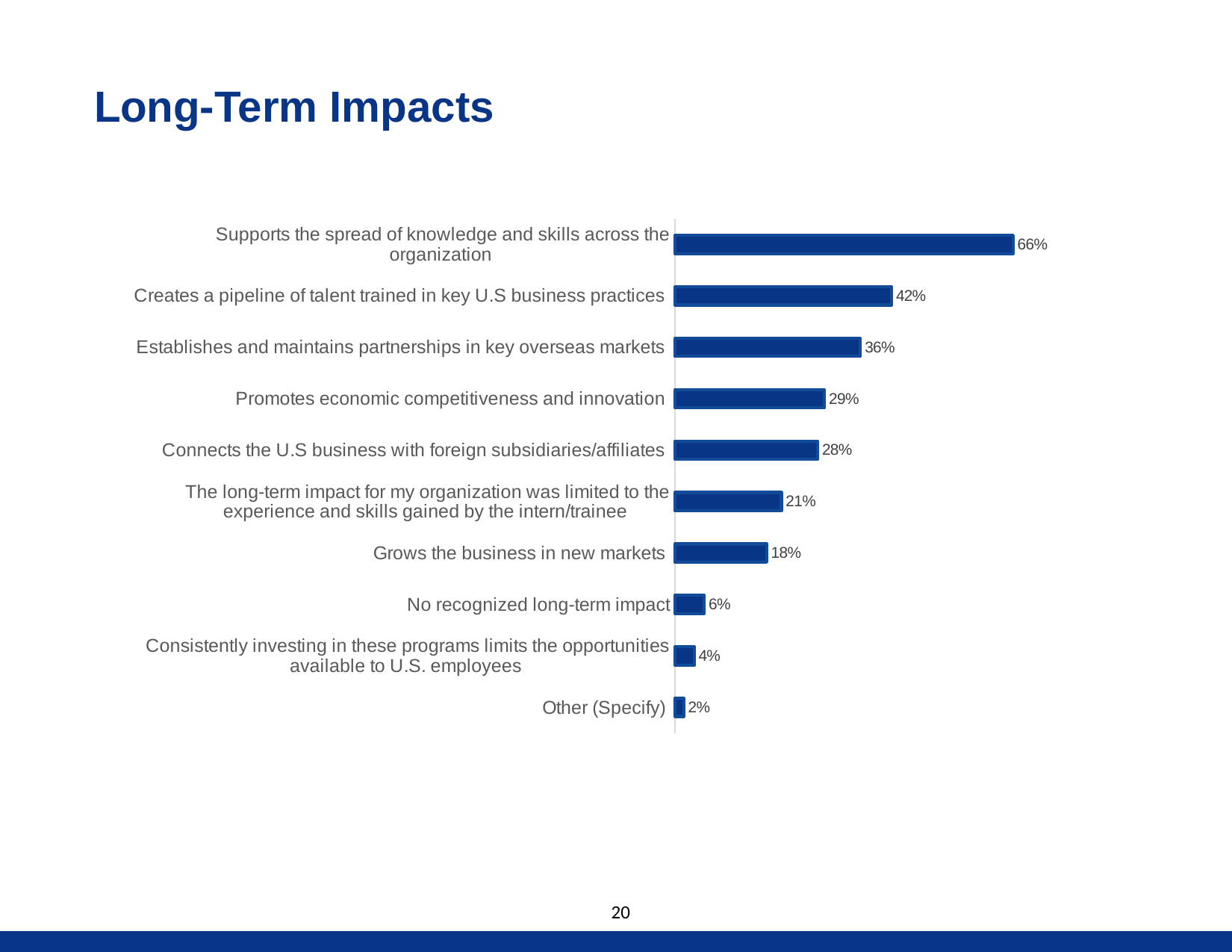
What is the difference between 'Establishes and maintains partnerships in key overseas markets' and 'Grows the business in new markets'? 18% What is the value for 'The long-term impact for my organization was limited to the experience and skills gained by the intern/trainee'? 21% Which category has the highest value? Supports the spread of knowledge and skills across the organization Which is larger: 'Promotes economic competitiveness and innovation' or 'Grows the business in new markets'? Promotes economic competitiveness and innovation What percentage is shown for 'No recognized long-term impact'? 6% What percentage is shown for 'Creates a pipeline of talent trained in key U.S business practices'? 42% What is the title of the slide? Long-Term Impacts What kind of chart is shown on the slide? Bar chart Which category has the lowest value? Other (Specify) How many categories are shown in the chart? 10 What is the difference between 'Supports the spread of knowledge and skills across the organization' and 'Creates a pipeline of talent trained in key U.S business practices'? 24% What is the value for 'Grows the business in new markets'? 18%